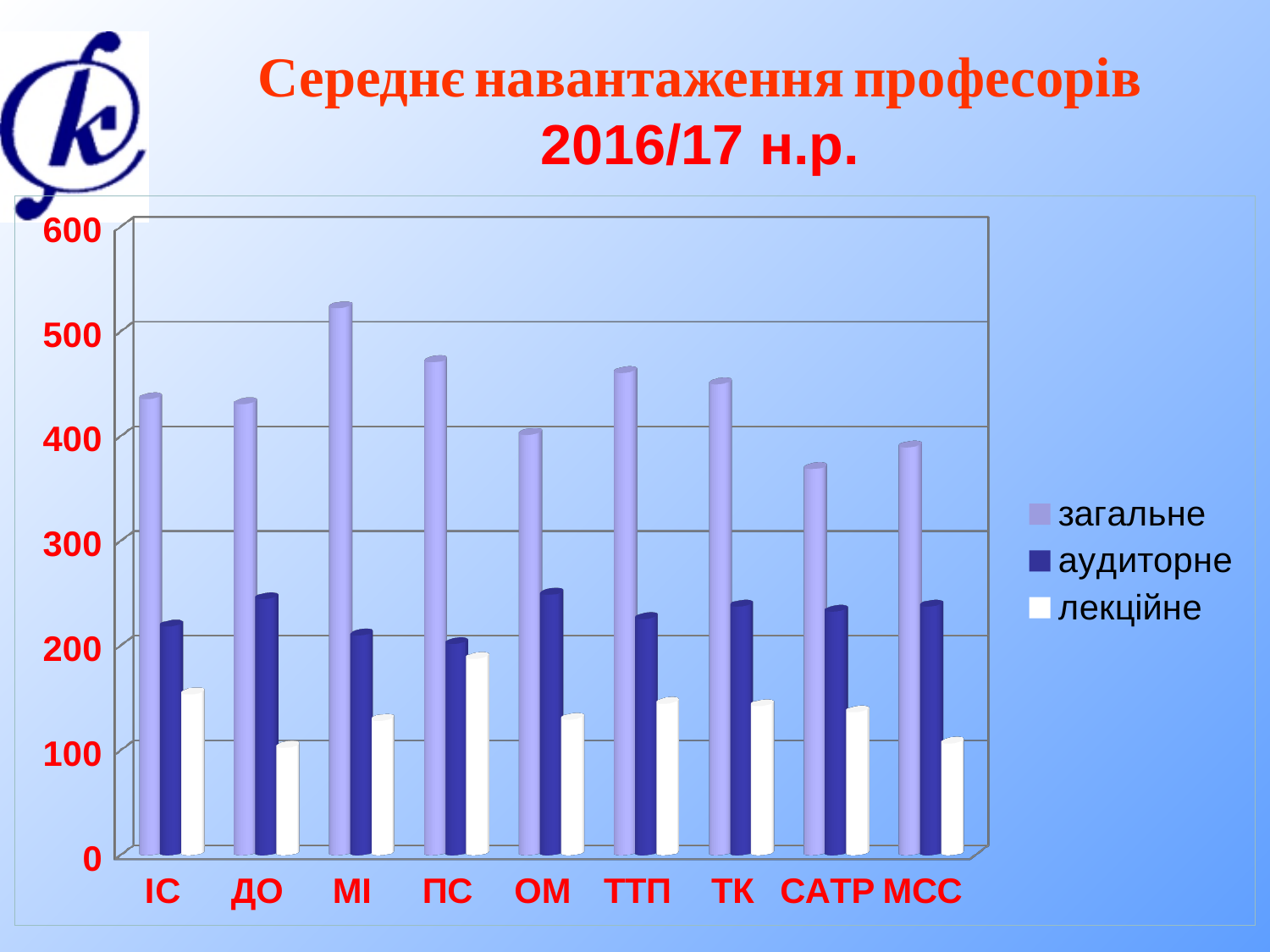
How many categories are shown on the x axis of the chart? 9 Which category has the highest value for the загальне series? МІ Which is larger, the загальне value for ТТП or for САТР? ТТП What kind of chart is shown on the slide? bar chart Which category has the lowest value for the аудиторне series? ПС How many series does the legend list? 3 Which category has the lowest value for the загальне series? САТР What is the title of the chart on the slide? Середнє навантаження професорів 2016/17 н.р. Is the загальне value for САТР greater or less than 400? less Is the загальне value for МІ greater or less than 500? greater Which category has the highest value for the лекційне series? ПС